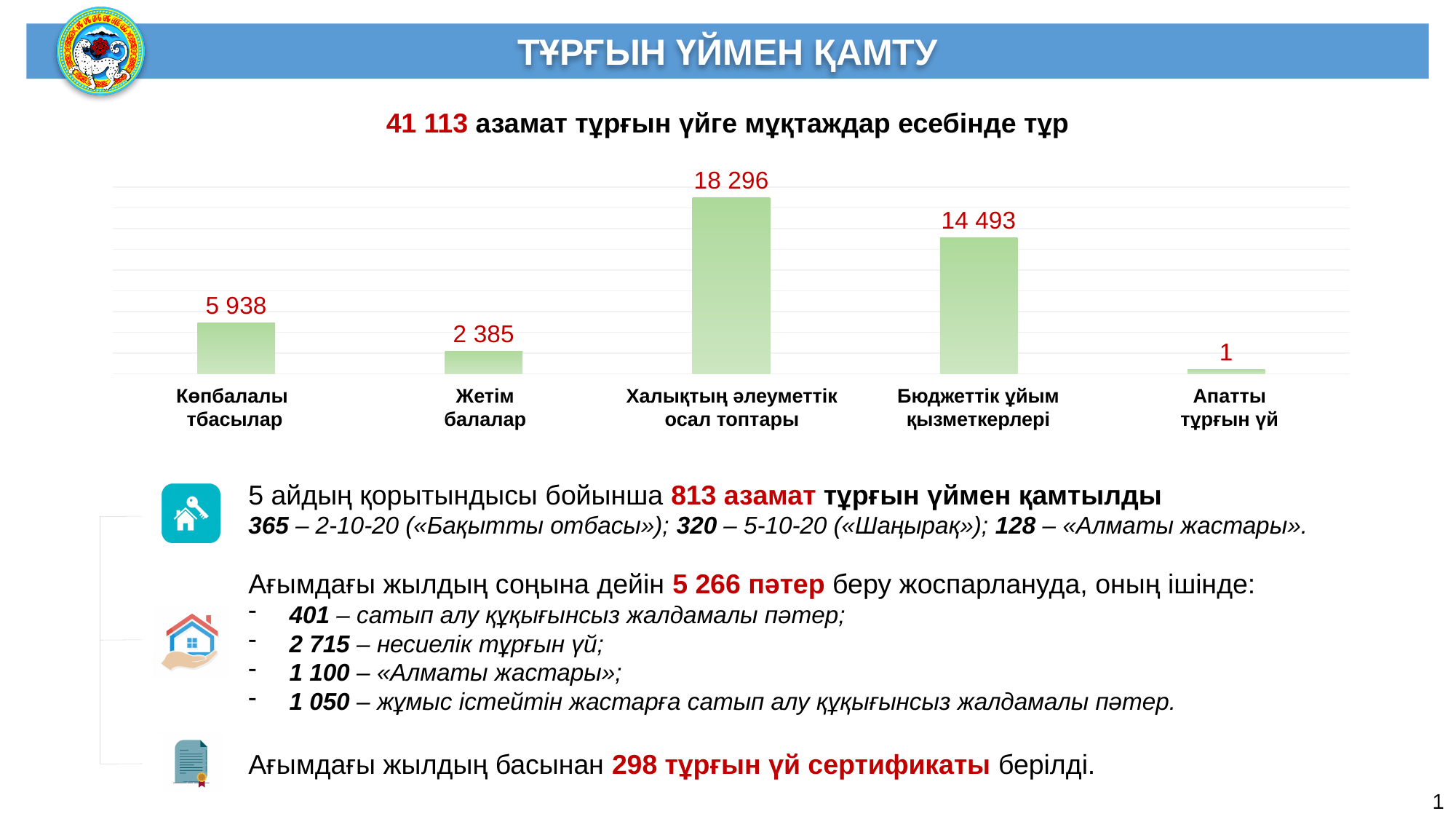
Which category has the lowest value? Апатты тұрғын үй How many categories are shown in the bar chart? 5 What is the value for Жетім балалар? 2 385 What kind of chart is shown on the slide? bar chart What is the value for Бюджеттік ұйым қызметкерлері? 14 493 What is the value for Халықтың әлеуметтік осал топтары? 18 296 What is the difference between the values for Көпбалалы отбасылар and Жетім балалар? 3 553 What colour are the bars in the chart? green Which category has the highest value? Халықтың әлеуметтік осал топтары Which is larger: the value for Көпбалалы отбасылар or the value for Жетім балалар? Көпбалалы отбасылар What is the difference between the values for Халықтың әлеуметтік осал топтары and Бюджеттік ұйым қызметкерлері? 3 803 What is the value for Апатты тұрғын үй? 1